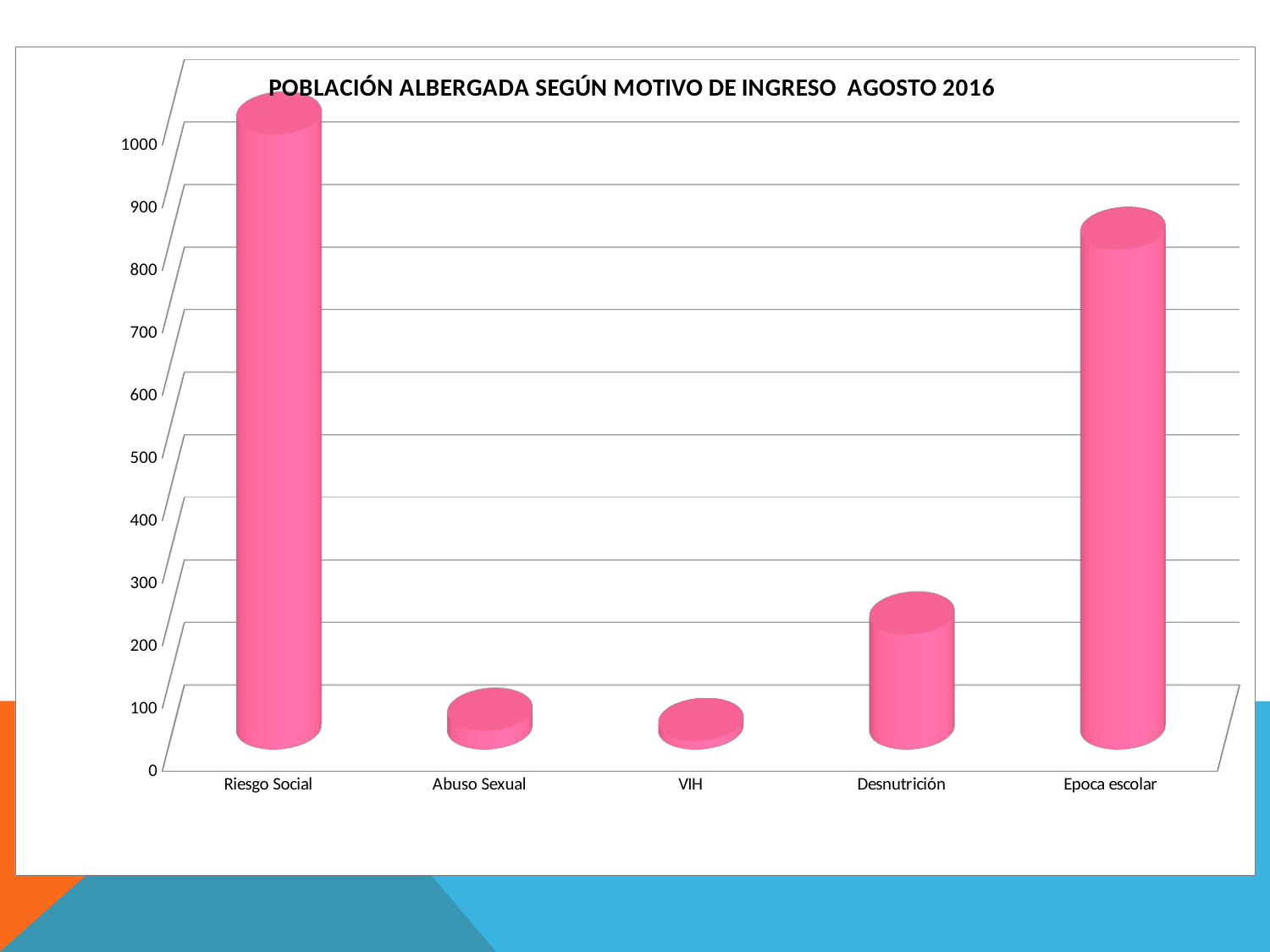
Is the value for Epoca escolar greater or less than 900? less Which is larger, the value for Epoca escolar or the value for Desnutrición? Epoca escolar Is the value for VIH greater or less than 200? less Which is larger, the value for Riesgo Social or the value for Epoca escolar? Riesgo Social Is the value for Desnutrición greater or less than 300? less Which category has the lowest value in the chart? VIH Which category has the highest value in the chart? Riesgo Social How many categories are shown on the x axis of the chart? 5 What is the title of the chart? POBLACIÓN ALBERGADA SEGÚN MOTIVO DE INGRESO AGOSTO 2016 What kind of chart is shown on the slide? bar chart